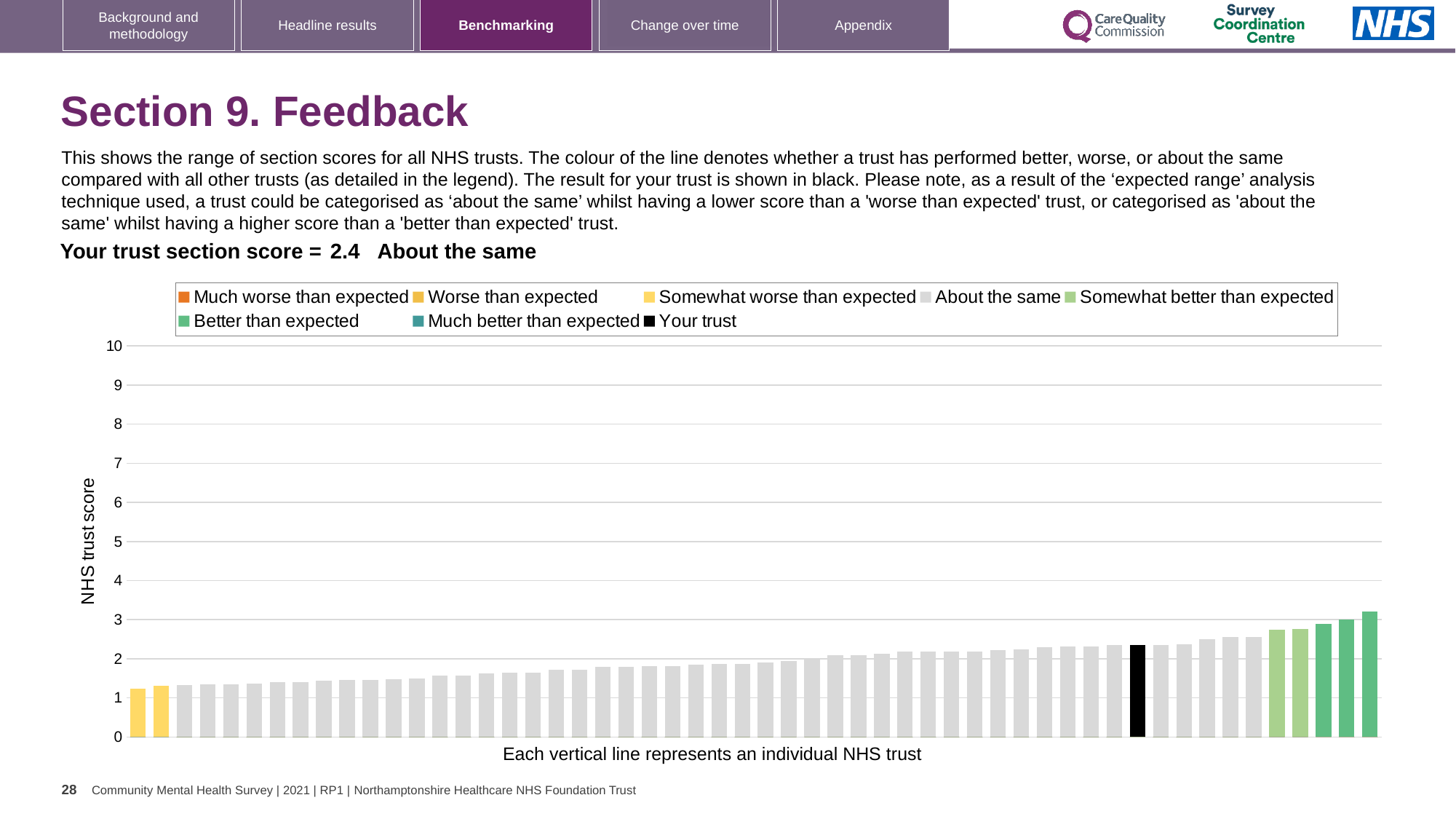
How many entries does the chart legend list? 8 What kind of chart is shown on the slide? bar chart How many bars are coloured yellow (Somewhat worse than expected)? 2 Which category is your trust placed in for this section? About the same Is the value of the black bar (your trust) greater or less than 3? less Is the value of the black bar (your trust) greater or less than 2? greater What is the section score for your trust? 2.4 Do the bar values rise or fall from left to right along the x axis? rise Is the value of the shortest bar greater or less than 2? less What is the label on the vertical axis? NHS trust score